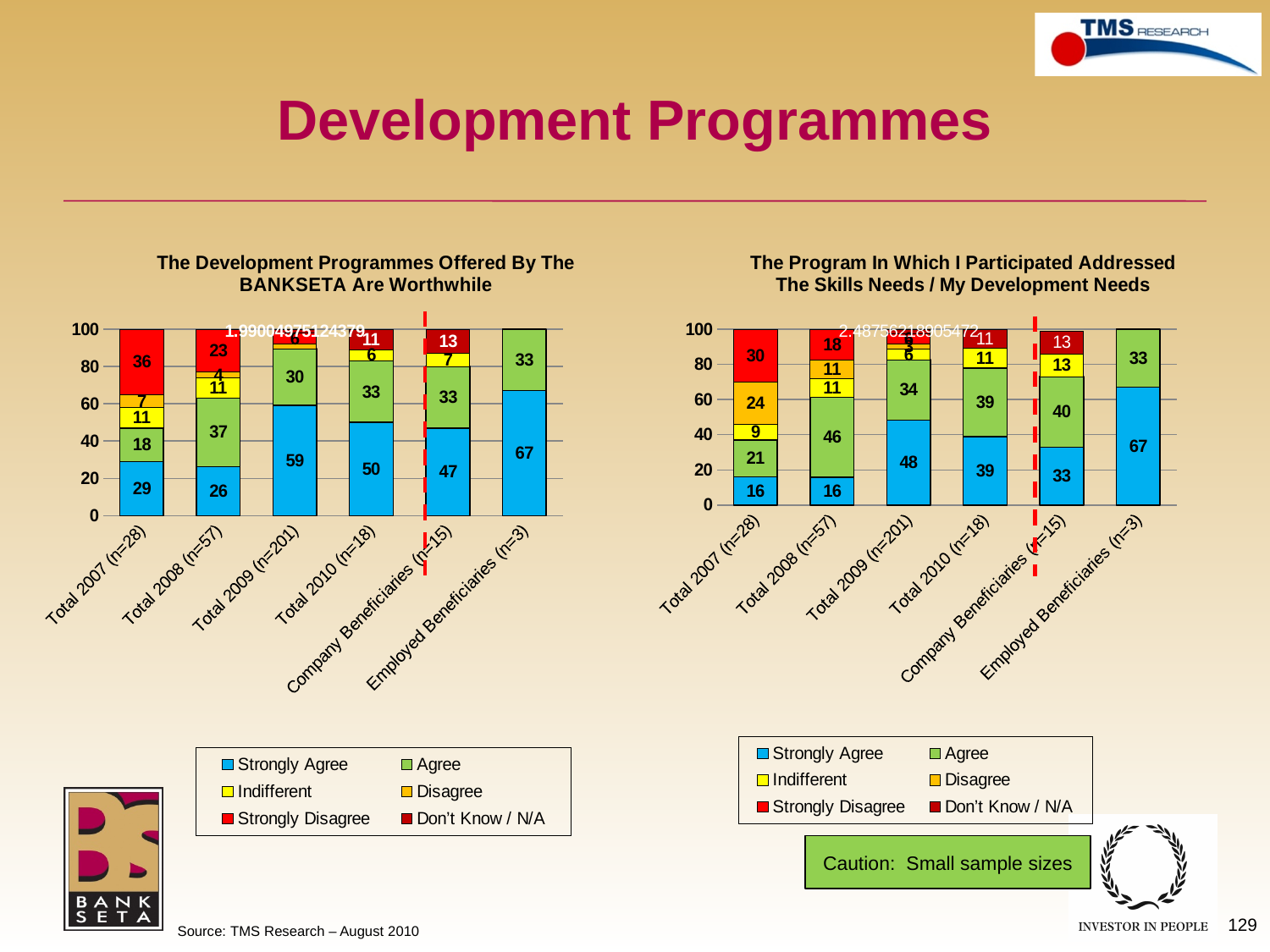
In the right chart (The Program In Which I Participated Addressed The Skills Needs / My Development Needs), what is the Agree value for Total 2008 (n=57)? 46 In the left chart (The Development Programmes Offered By The BANKSETA Are Worthwhile), which category has the lowest Strongly Agree value? Total 2008 (n=57) In the left chart (The Development Programmes Offered By The BANKSETA Are Worthwhile), which category has the highest Strongly Agree value? Employed Beneficiaries (n=3) In the right chart (The Program In Which I Participated Addressed The Skills Needs / My Development Needs), what is the Disagree value for Total 2007 (n=28)? 24 What kind of chart is the left chart (The Development Programmes Offered By The BANKSETA Are Worthwhile)? Stacked bar chart How many series does the legend of the right chart (The Program In Which I Participated Addressed The Skills Needs / My Development Needs) list? 6 In the left chart (The Development Programmes Offered By The BANKSETA Are Worthwhile), what is the Strongly Agree value for Total 2009 (n=201)? 59 In the left chart (The Development Programmes Offered By The BANKSETA Are Worthwhile), what is the Strongly Disagree value for Total 2007 (n=28)? 36 How many categories are shown on the x axis of the left chart (The Development Programmes Offered By The BANKSETA Are Worthwhile)? 6 In the right chart (The Program In Which I Participated Addressed The Skills Needs / My Development Needs), which is larger: the Strongly Agree value for Total 2009 (n=201) or for Company Beneficiaries (n=15)? Total 2009 (n=201) In the left chart (The Development Programmes Offered By The BANKSETA Are Worthwhile), what is the difference between the Agree values for Total 2008 (n=57) and Total 2007 (n=28)? 19 In the right chart (The Program In Which I Participated Addressed The Skills Needs / My Development Needs), what is the difference between the Strongly Disagree values for Total 2007 (n=28) and Total 2008 (n=57)? 12